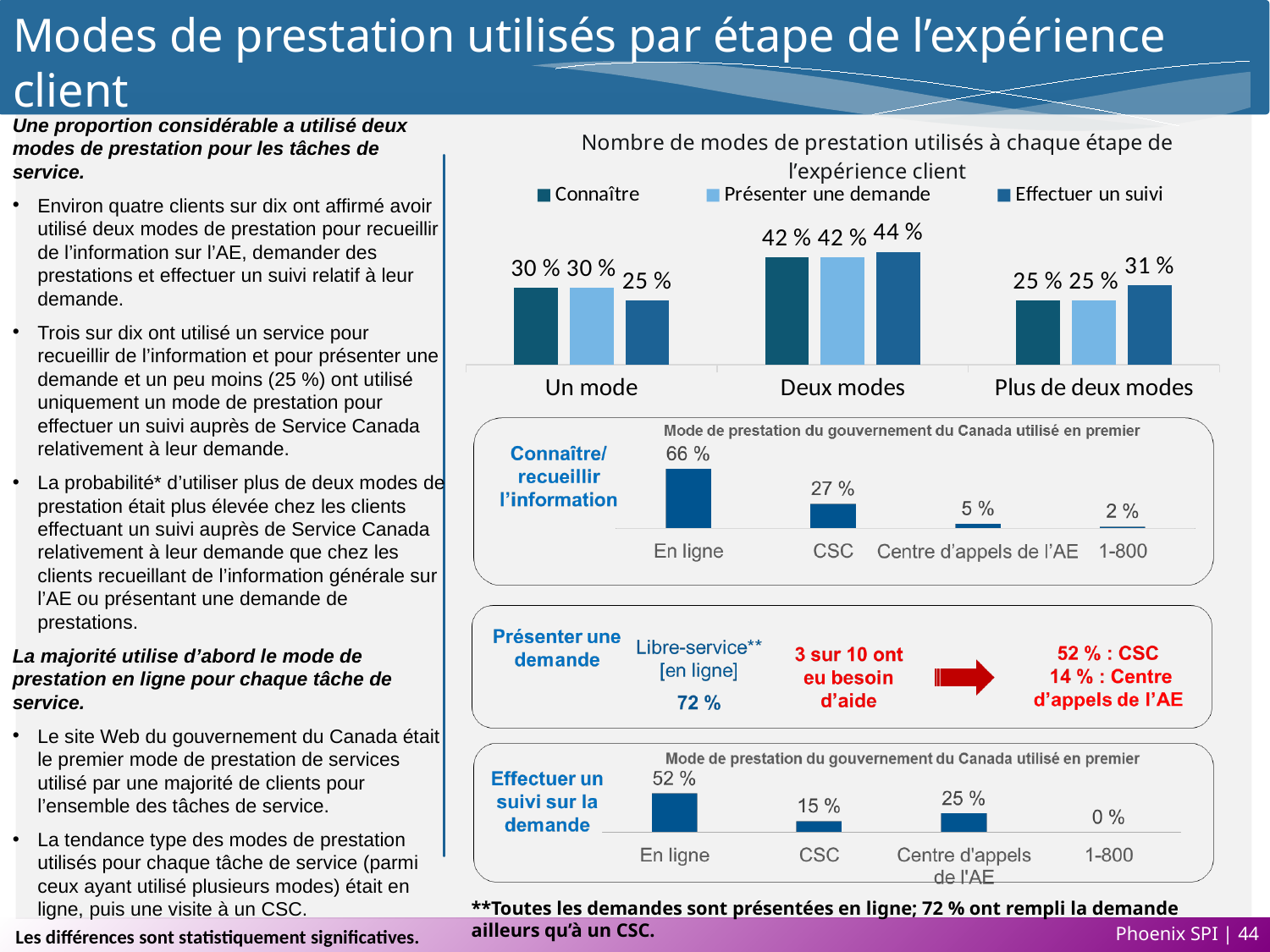
In the 'Effectuer un suivi sur la demande' chart, what is the value for 'Centre d'appels de l'AE'? 25 % In the 'Effectuer un suivi sur la demande' chart, what is the difference between 'En ligne' and 'CSC'? 37 % In the chart 'Nombre de modes de prestation utilisés à chaque étape de l'expérience client', what is the difference between 'Effectuer un suivi' and 'Connaître' in the 'Plus de deux modes' category? 6 % What kind of chart is 'Nombre de modes de prestation utilisés à chaque étape de l'expérience client'? Bar chart In the chart 'Nombre de modes de prestation utilisés à chaque étape de l'expérience client', what is the value for 'Connaître' in the 'Un mode' category? 30 % In the chart 'Nombre de modes de prestation utilisés à chaque étape de l'expérience client', what is the value for 'Effectuer un suivi' in the 'Deux modes' category? 44 % In the chart 'Nombre de modes de prestation utilisés à chaque étape de l'expérience client', how many categories are shown on the x axis? 3 In the 'Connaître/recueillir l'information' chart, which mode has the lowest value? 1-800 In the chart 'Nombre de modes de prestation utilisés à chaque étape de l'expérience client', which category has the highest value for 'Effectuer un suivi'? Deux modes In the chart 'Nombre de modes de prestation utilisés à chaque étape de l'expérience client', how many series does the legend list? 3 In the 'Effectuer un suivi sur la demande' chart, which is larger: the value for 'CSC' or the value for 'Centre d'appels de l'AE'? Centre d'appels de l'AE In the 'Connaître/recueillir l'information' chart, what is the value for 'En ligne'? 66 %